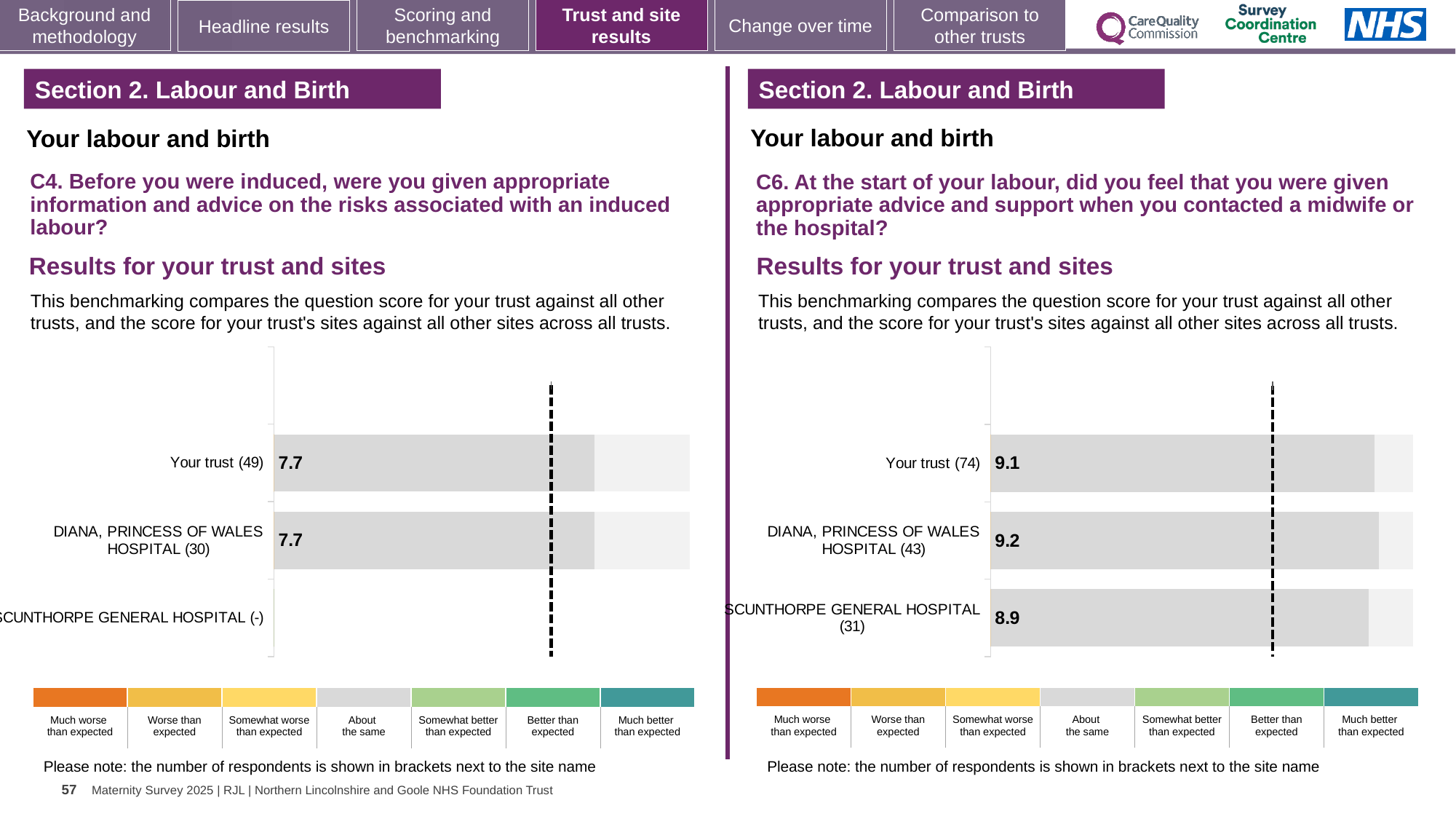
In the C6 chart on the right, what is the difference between the scores for Diana, Princess of Wales Hospital and Scunthorpe General Hospital? 0.3 In the C6 chart on the right, what is the score for Your trust? 9.1 What kind of chart is used in the C6 chart on the right? Bar chart In the C6 chart on the right, what is the score for Scunthorpe General Hospital? 8.9 How many sites or trusts are listed on the y axis of the C4 chart on the left? 3 In the C4 chart on the left, what is the score for Your trust? 7.7 In the C6 chart on the right, which site or trust has the lowest score? Scunthorpe General Hospital In the C6 chart on the right, which site or trust has the highest score? Diana, Princess of Wales Hospital In the C6 chart on the right, which has the larger score: Your trust or Scunthorpe General Hospital? Your trust In the C4 chart on the left, how many respondents are shown in brackets for Your trust? 49 In the C6 chart on the right, how many respondents are shown in brackets for Diana, Princess of Wales Hospital? 43 In the C4 chart on the left, what is the score for Diana, Princess of Wales Hospital? 7.7